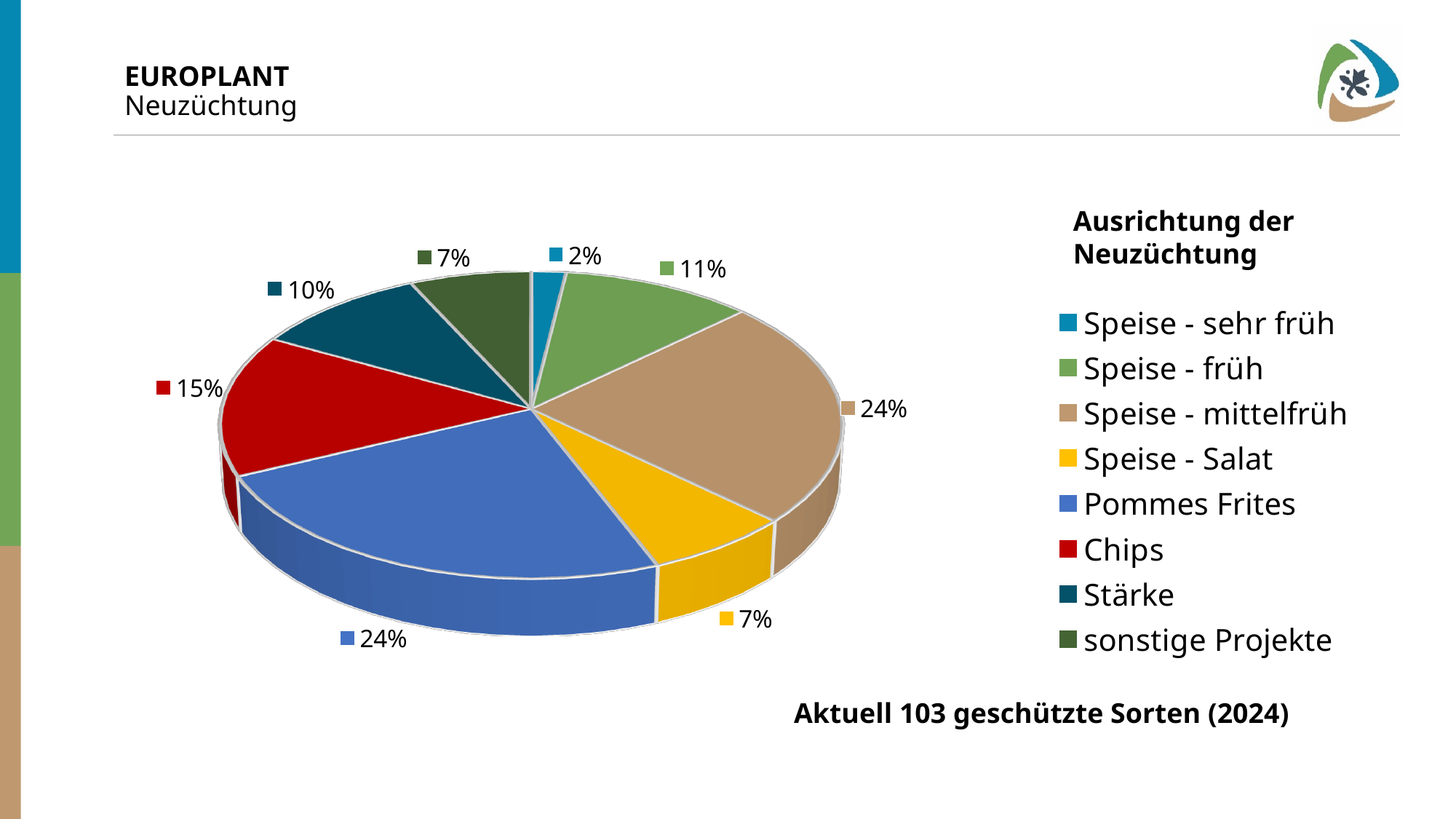
What share of the pie does Speise - mittelfrüh have? 24% What is the difference in percentage points between the share for Pommes Frites and the share for Chips? 9 How many categories does the pie chart show? 8 What share of the pie does Speise - sehr früh have? 2% Which legend entry is shown in red? Chips Which is larger, the share for Chips or the share for Stärke? Chips What share of the pie does Speise - früh have? 11% What kind of chart is shown on the slide? Pie chart Which category has the smallest slice of the pie? Speise - sehr früh What is the title of the chart? Ausrichtung der Neuzüchtung